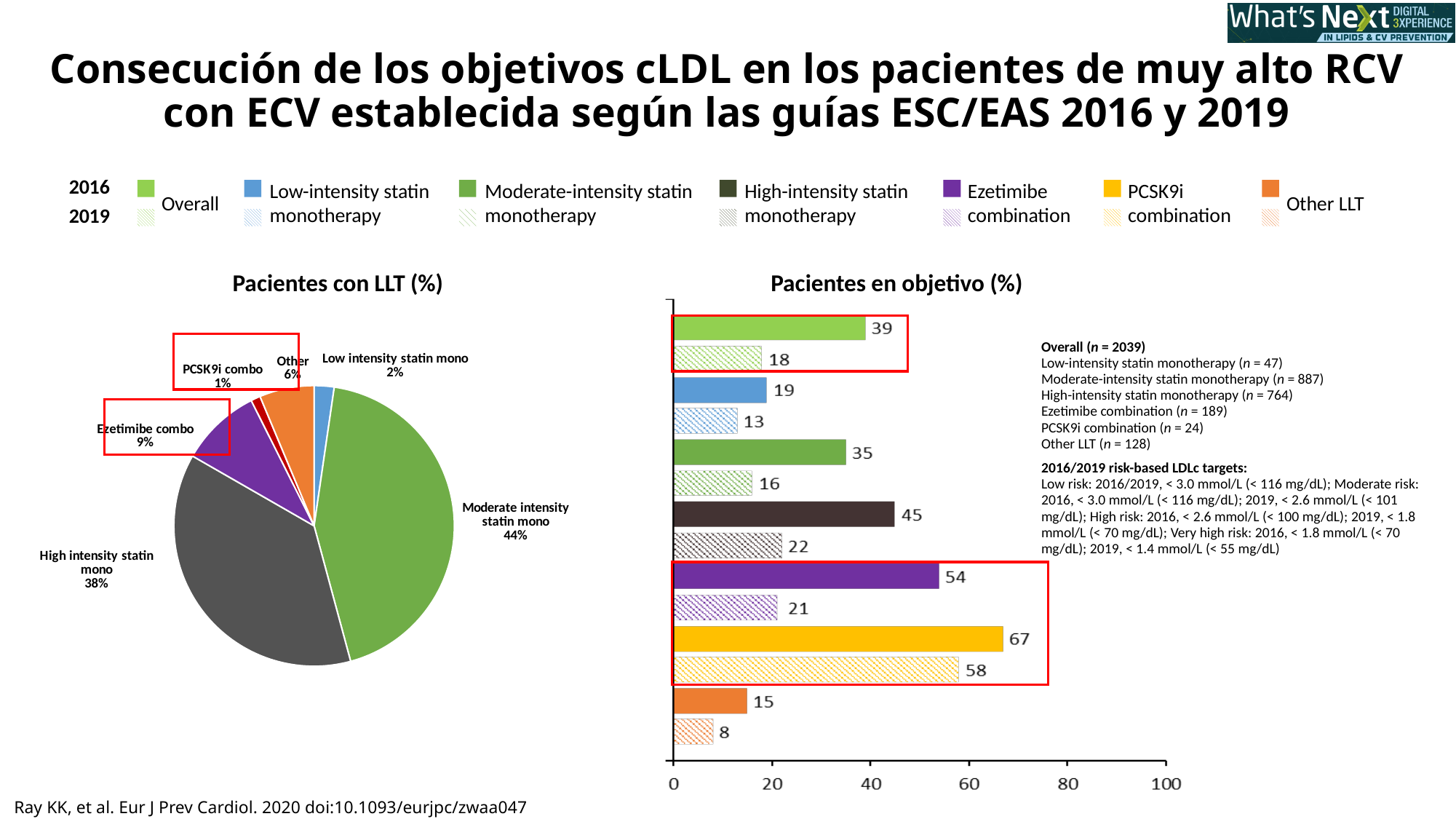
What kind of chart is 'Pacientes en objetivo (%)'? Bar chart In the 'Pacientes en objetivo (%)' chart, what is the 2016 value for PCSK9i combination? 67 In the 'Pacientes con LLT (%)' chart, which category has the smallest slice? PCSK9i combo In the 'Pacientes en objetivo (%)' chart, which is larger: the 2016 value for high-intensity statin monotherapy or the 2016 value for moderate-intensity statin monotherapy? High-intensity statin monotherapy In the 'Pacientes con LLT (%)' chart, what is the difference between the high intensity statin mono share and the ezetimibe combo share? 29% How many series (years) does the legend list for the 'Pacientes en objetivo (%)' chart? 2 In the 'Pacientes con LLT (%)' chart, which category has the largest slice? Moderate intensity statin mono What kind of chart is 'Pacientes con LLT (%)'? Pie chart In the 'Pacientes en objetivo (%)' chart, what is the 2019 value for Overall? 18 In the 'Pacientes en objetivo (%)' chart, what is the difference between the 2016 and 2019 values for ezetimibe combination? 33 In the 'Pacientes en objetivo (%)' chart, which category has the lowest 2019 value? Other LLT In the 'Pacientes con LLT (%)' chart, what share of patients received moderate intensity statin monotherapy? 44%